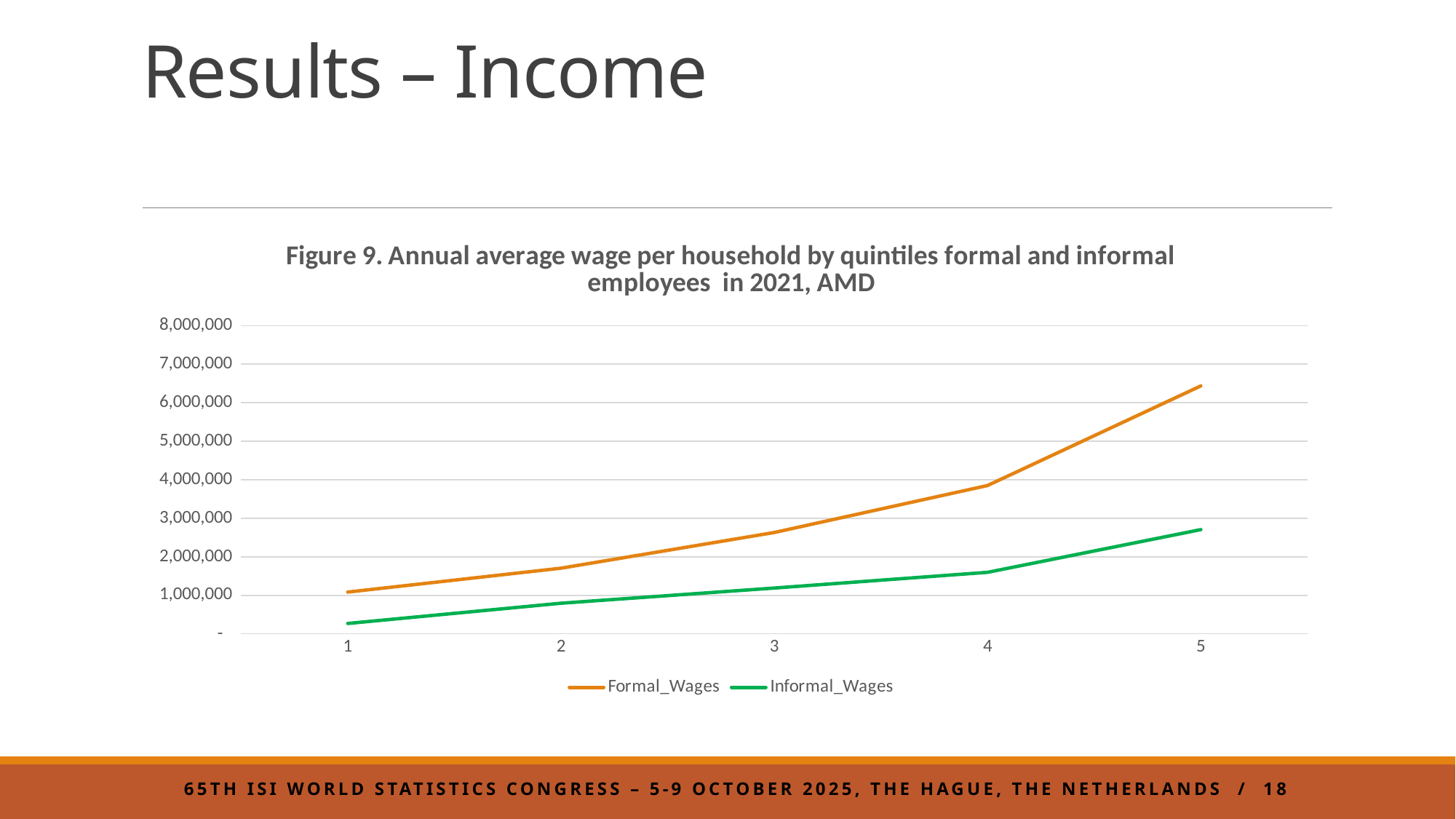
What kind of chart is shown on the slide? line chart How many series does the legend list? 2 At which quintile is Formal_Wages highest? 5 How many quintiles are plotted along the x axis? 5 Do the Formal_Wages values rise or fall from quintile 1 to quintile 5? rise Is the Formal_Wages value for quintile 3 greater or less than 3,000,000? less Is the Formal_Wages value for quintile 5 greater or less than 6,000,000? greater Do the Informal_Wages values rise or fall from quintile 1 to quintile 5? rise Which colour is used for the Informal_Wages line? green Is the Informal_Wages value for quintile 1 greater or less than 1,000,000? less At which quintile is Informal_Wages lowest? 1 At quintile 5, which series has the larger value, Formal_Wages or Informal_Wages? Formal_Wages